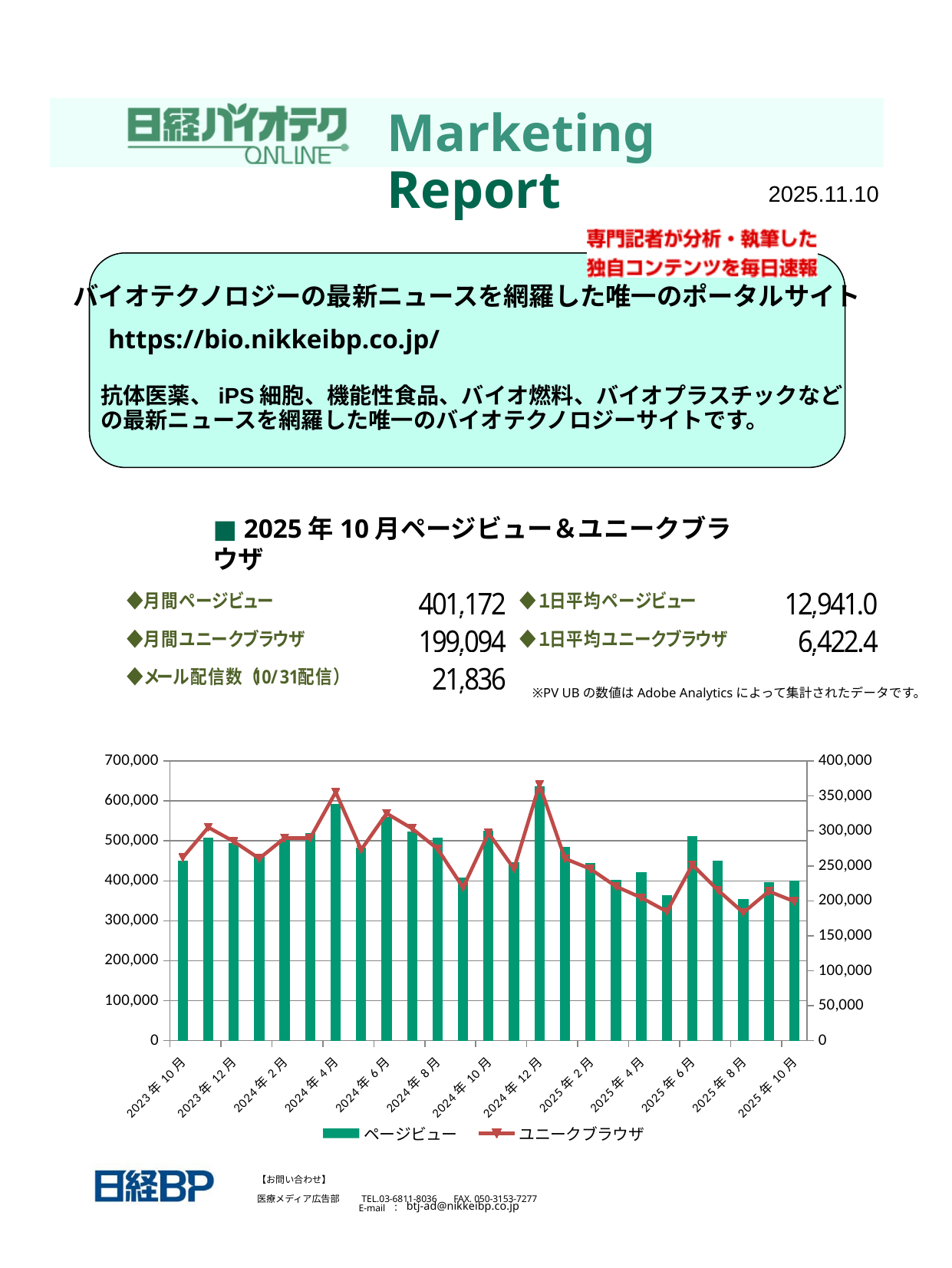
How many monthly bars are plotted in the chart? 25 Which month has the larger ページビュー value, 2023年10月 or 2024年4月? 2024年4月 Do the ページビュー values generally rise or fall from 2024年12月 to 2025年5月? fall Is the ページビュー value for 2025年5月 greater or less than 400,000? less Is the ユニークブラウザ value for 2024年12月 greater or less than 350,000? greater Which month has the highest ページビュー bar in the chart? 2024年12月 How many series does the chart legend list? 2 Which series is drawn as a line in the chart? ユニークブラウザ Which month has the highest ユニークブラウザ value in the chart? 2024年12月 Is the ページビュー value for 2024年4月 greater or less than 500,000? greater What kind of chart is shown on the slide? A combined bar and line chart What are the two series named in the chart legend? ページビュー and ユニークブラウザ